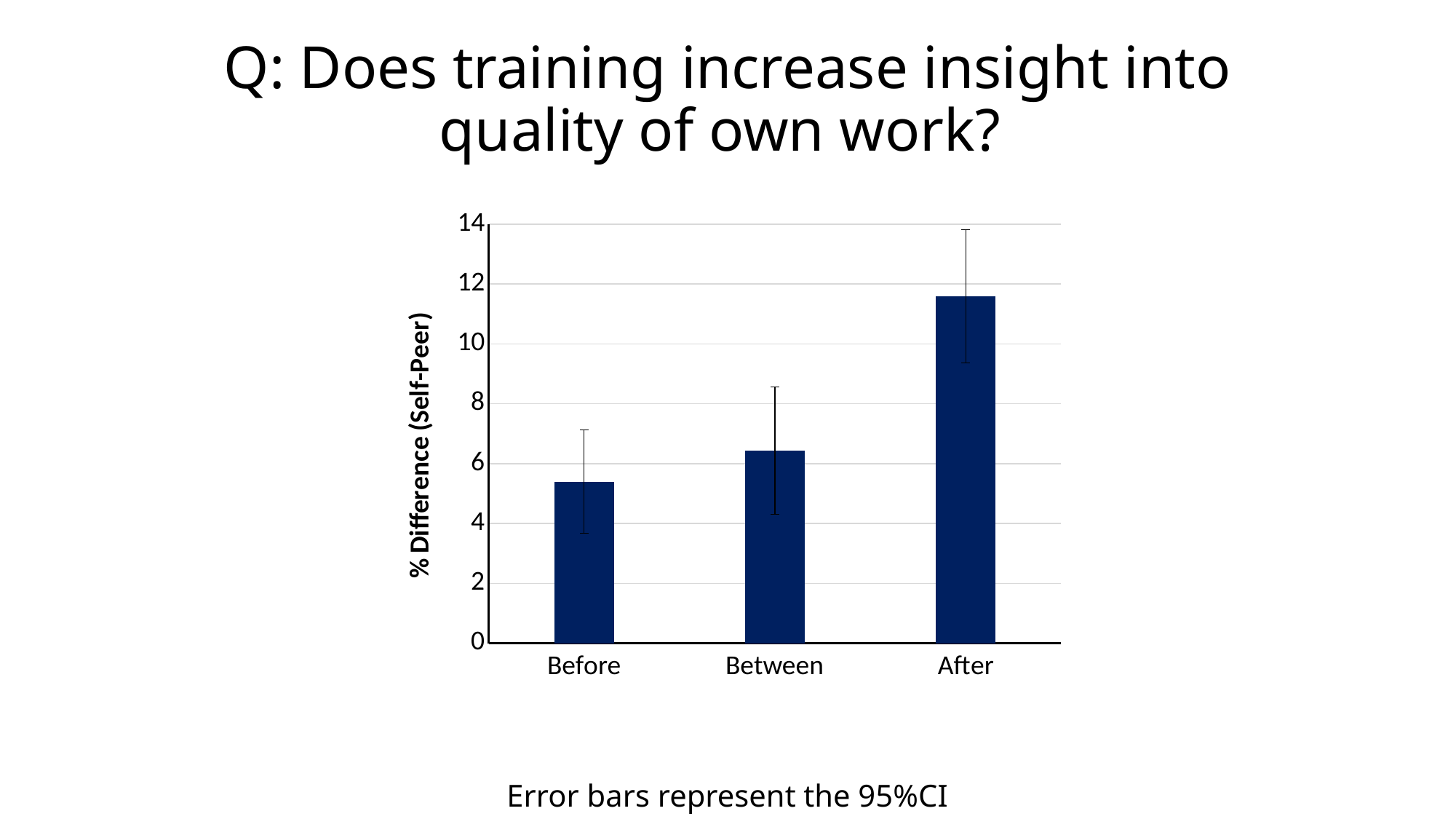
Do the values rise or fall from Before to After along the x axis? rise What kind of chart is shown on the slide? bar chart Which category has the lowest % Difference (Self-Peer)? Before How many categories are plotted on the x axis? 3 Is the value for Before greater or less than 6? less Which is larger, the value for After or the value for Between? After Is the value for Between greater or less than 8? less Is the value for After greater or less than 10? greater What is the label of the y axis? % Difference (Self-Peer) Which category has the highest % Difference (Self-Peer)? After According to the note below the chart, what do the error bars represent? the 95%CI